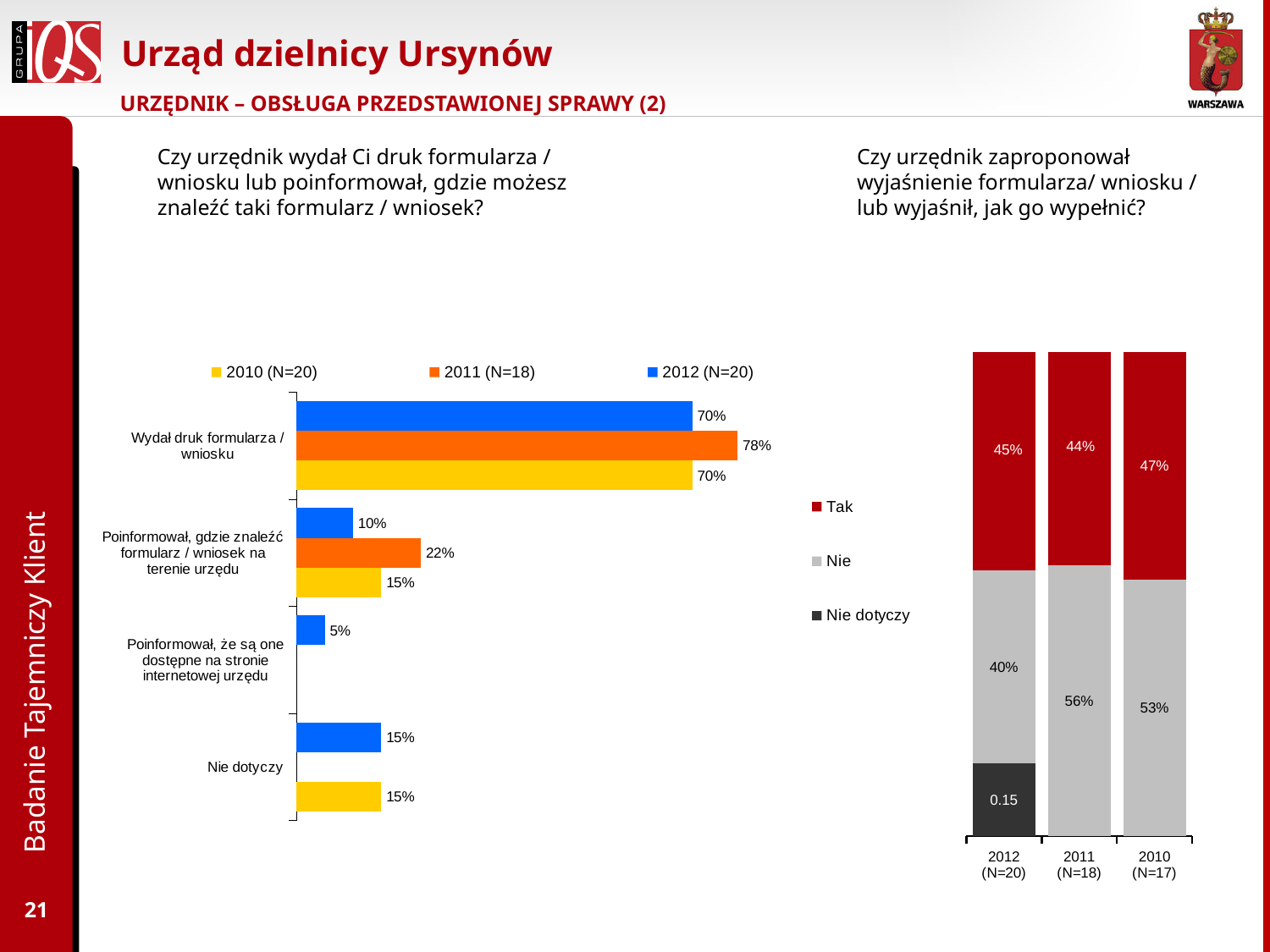
On the left chart, which year has the highest value for 'Wydał druk formularza / wniosku'? 2011 (N=18) On the left chart, how many series does the legend list? 3 On the left chart, what is the 2012 (N=20) value for 'Poinformował, że są one dostępne na stronie internetowej urzędu'? 5% On the right chart, what is the 'Nie' value for 2011 (N=18)? 56% On the right chart, which legend entry is shown in red? Tak On the right chart, what is the 'Tak' value for 2010 (N=17)? 47% What kind of chart is the left chart? Bar chart On the left chart, what is the difference between the 2011 and 2012 values for 'Poinformował, gdzie znaleźć formularz / wniosek na terenie urzędu'? 12% On the left chart, how many categories are shown on the vertical axis? 4 On the left chart, what is the 2012 (N=20) value for 'Poinformował, gdzie znaleźć formularz / wniosek na terenie urzędu'? 10% On the left chart, what is the 2011 (N=18) value for 'Wydał druk formularza / wniosku'? 78% On the right chart, is the 'Nie' value larger for 2012 (N=20) or 2010 (N=17)? 2010 (N=17)